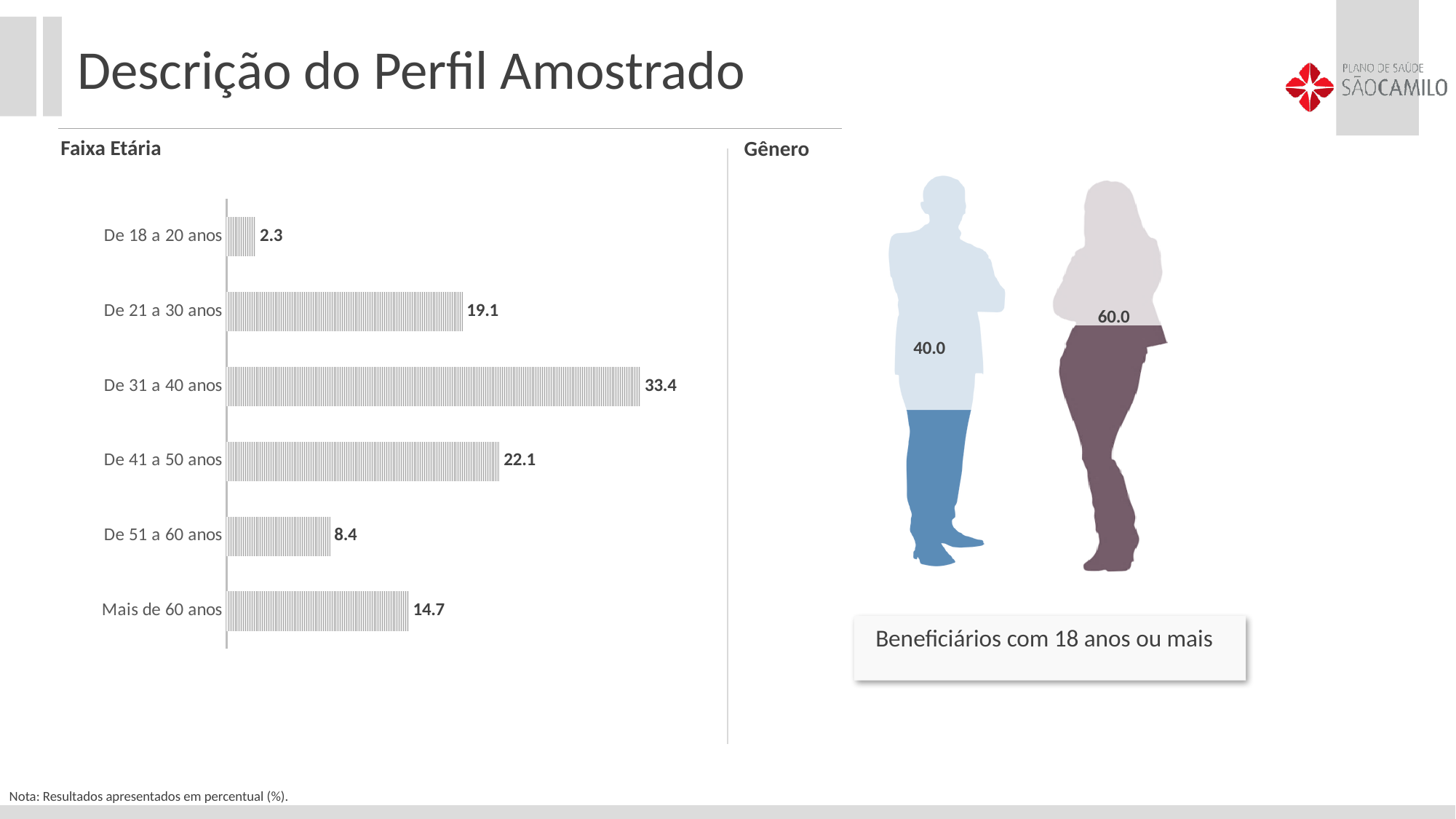
How many age groups are shown in the Faixa Etária chart? 6 In the Faixa Etária chart, which age group has the lowest value? De 18 a 20 anos In the Faixa Etária chart, what is the difference between the values for De 21 a 30 anos and De 51 a 60 anos? 10.7 In the Gênero section, what is the value shown for the male figure? 40.0 In the Faixa Etária chart, what is the value for De 31 a 40 anos? 33.4 In the Faixa Etária chart, what is the difference between the values for De 31 a 40 anos and De 41 a 50 anos? 11.3 In the Gênero section, what is the value shown for the female figure? 60.0 In the Faixa Etária chart, which is larger: the value for De 41 a 50 anos or the value for Mais de 60 anos? De 41 a 50 anos What kind of chart is the Faixa Etária chart? Bar chart In the Faixa Etária chart, which age group has the highest value? De 31 a 40 anos In the Faixa Etária chart, what is the value for De 18 a 20 anos? 2.3 In the Faixa Etária chart, what is the value for Mais de 60 anos? 14.7